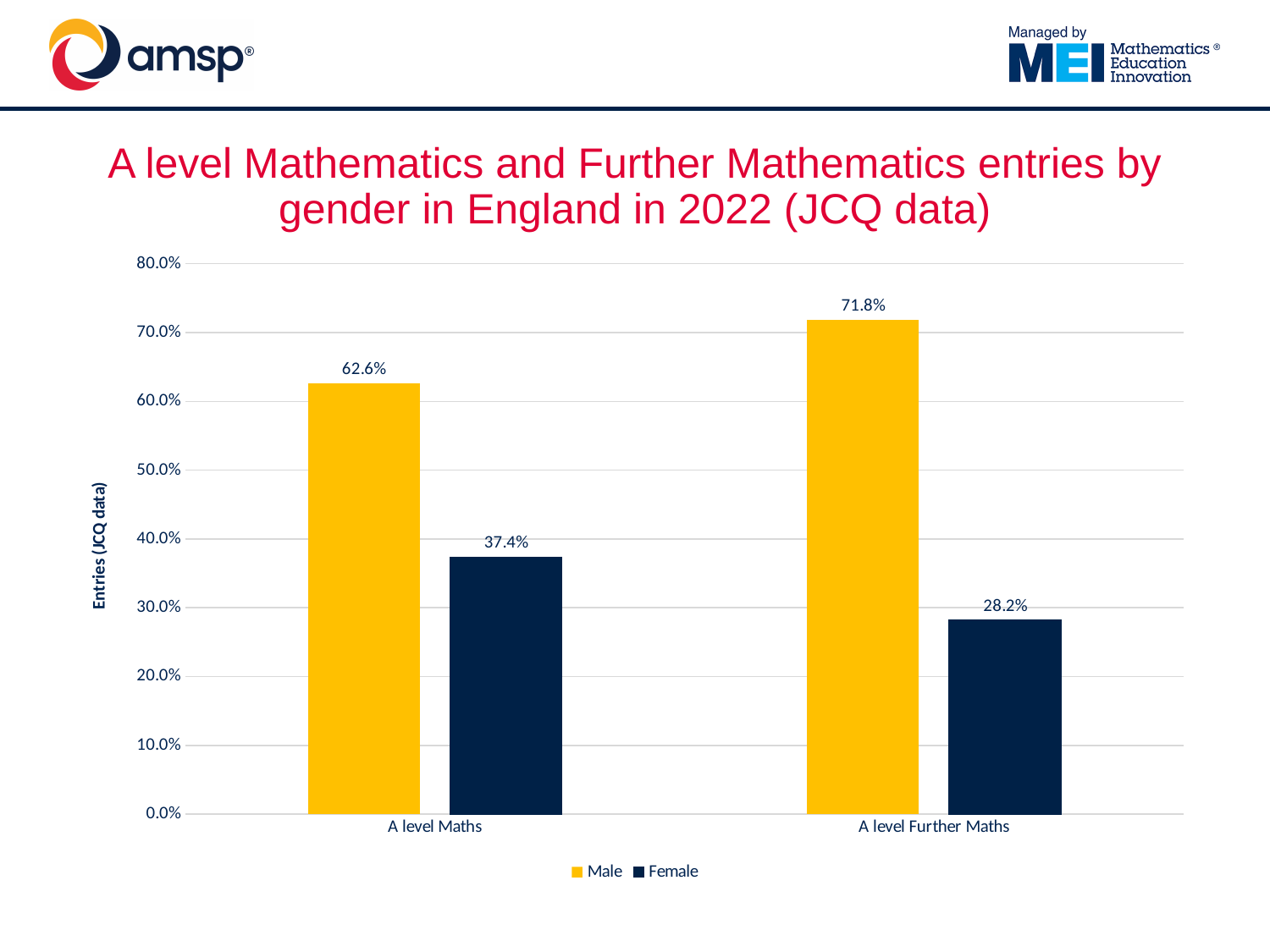
Which bar has the lowest value on the chart? Female, A level Further Maths What is the difference between the Male values for A level Further Maths and A level Maths? 9.2% Which bar has the highest value on the chart? Male, A level Further Maths What is the Female value for A level Maths? 37.4% What kind of chart is shown on the slide? Bar chart What is the Female value for A level Further Maths? 28.2% Which is larger: the Female value for A level Maths or the Female value for A level Further Maths? A level Maths How many categories are shown on the x axis? 2 How many series does the legend list? 2 What is the Male value for A level Further Maths? 71.8% What is the difference between the Male and Female values for A level Maths? 25.2% What is the Male value for A level Maths? 62.6%